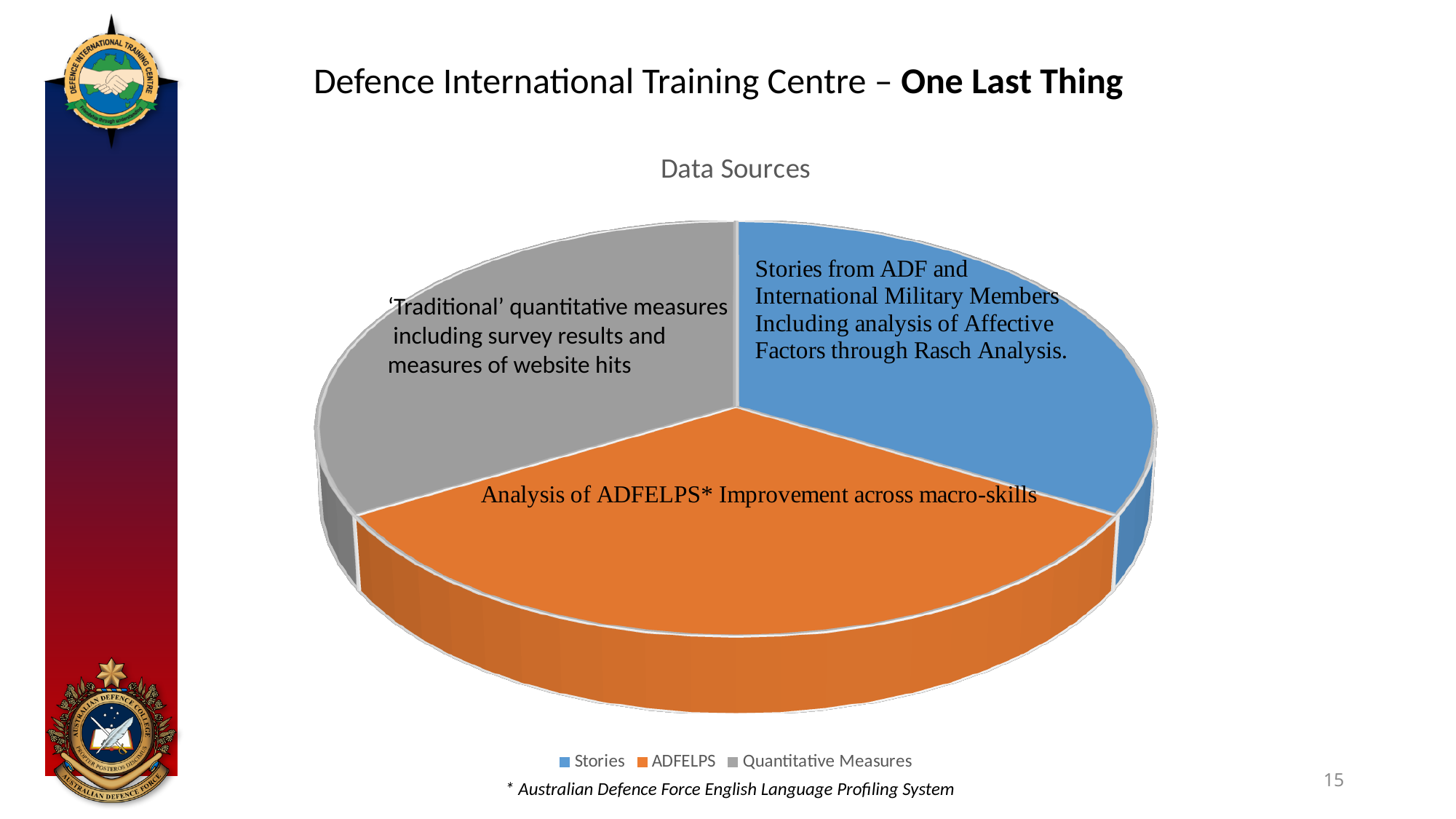
Which legend entry is shown in blue? Stories Which slice of the pie chart is labelled with 'Traditional' quantitative measures including survey results and measures of website hits? Quantitative Measures What is the title of the chart? Data Sources Which colour represents the ADFELPS slice in the pie chart? orange Which legend entry is shown in grey? Quantitative Measures How many entries does the chart legend list? 3 How many slices does the pie chart have? 3 What are the three categories listed in the chart legend? Stories, ADFELPS, Quantitative Measures Which slice of the pie chart carries the label 'Analysis of ADFELPS* Improvement across macro-skills'? ADFELPS What kind of chart is shown on the slide? pie chart